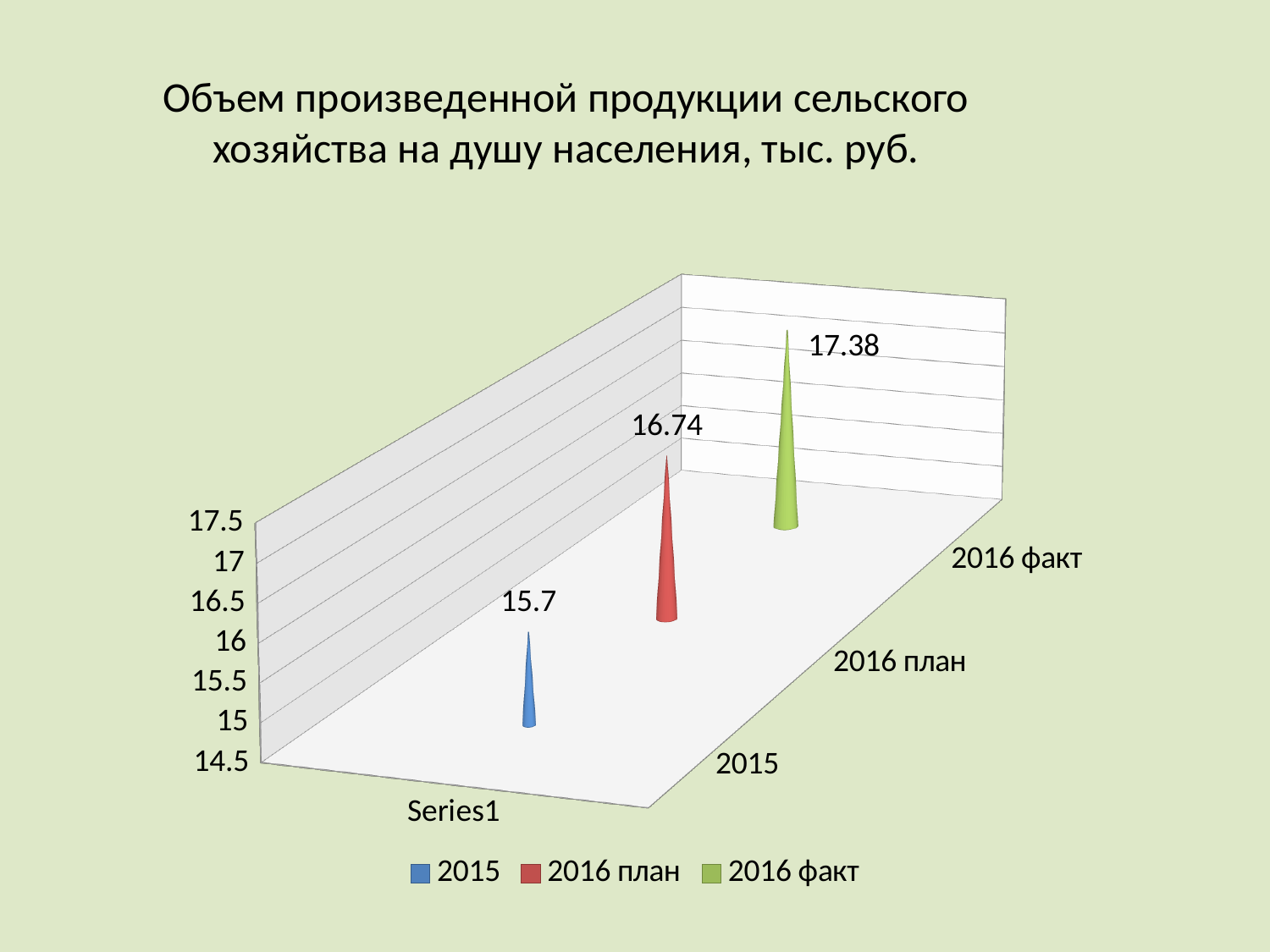
What is the difference between the 2016 факт value and the 2016 план value? 0.64 Which is larger, the value for 2016 план or the value for 2015? 2016 план What is the difference between the 2016 план value and the 2015 value? 1.04 How many series does the legend list? 3 Which series has the highest value? 2016 факт What is the value for 2015? 15.7 Which series has the lowest value? 2015 What is the value for 2016 факт? 17.38 What is the value for 2016 план? 16.74 What kind of chart is shown on the slide? bar chart Is the value for 2016 факт greater or less than 17? greater What is the title of the chart? Объем произведенной продукции сельского хозяйства на душу населения, тыс. руб.